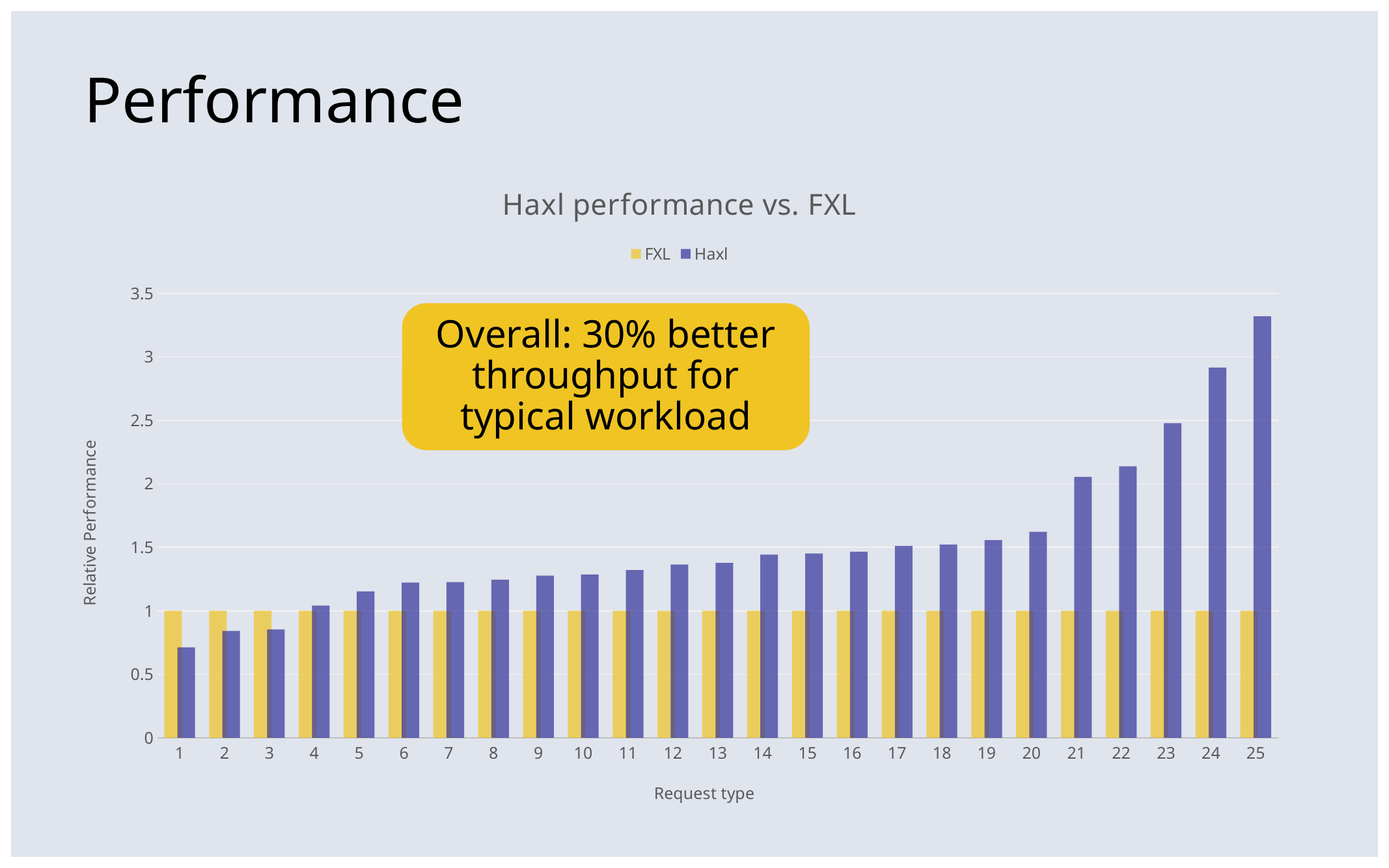
Which request type has the highest Haxl value? 25 What is the FXL value for request type 1? 1 What is the title of the chart? Haxl performance vs. FXL Is the Haxl value for request type 21 greater or less than 2? greater How many series does the legend list? 2 Do the Haxl values rise or fall as the request type number increases along the x axis? rise How many request types are shown on the x axis? 25 Is the Haxl value for request type 25 greater or less than 3? greater What kind of chart is shown on the slide? Bar chart For request type 2, which is larger, the FXL value or the Haxl value? FXL Which request type has the lowest Haxl value? 1 What is the label of the y axis? Relative Performance